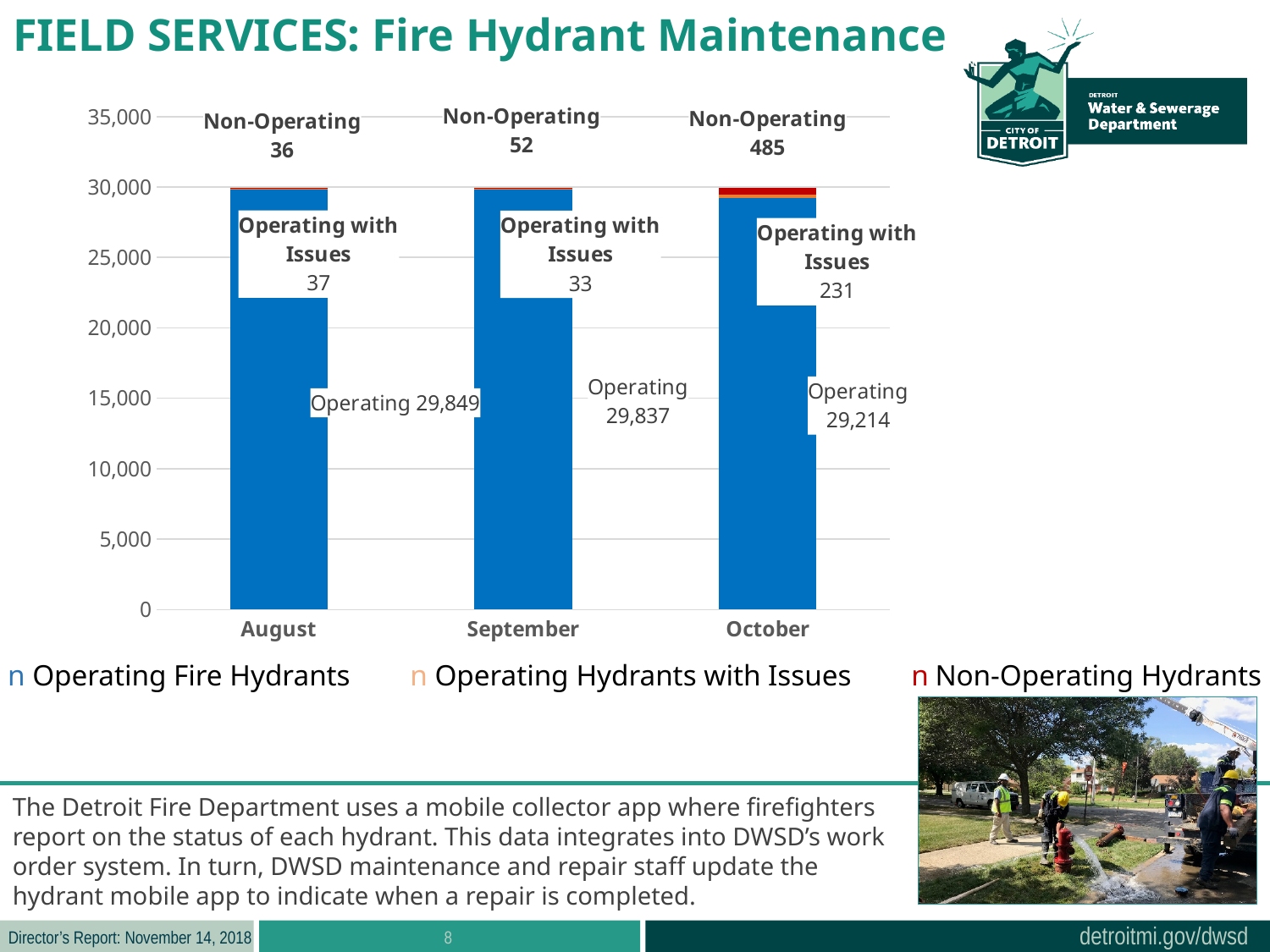
What is the Non-Operating hydrant count for October? 485 How many months are shown on the x axis of the chart? 3 Which month has the highest number of Non-Operating hydrants? October How many series does the legend list? 3 Which month has the lowest number of Operating hydrants? October Is the Operating hydrant value for October greater or less than 25,000? greater What is the total number of hydrants in the October stacked bar? 29,930 What is the difference between the Non-Operating hydrant counts in October and September? 433 What kind of chart is shown on the slide? Stacked bar chart How many Operating fire hydrants were there in August? 29,849 Which is larger: the Operating with Issues count in August or in September? August How many hydrants were Operating with Issues in September? 33